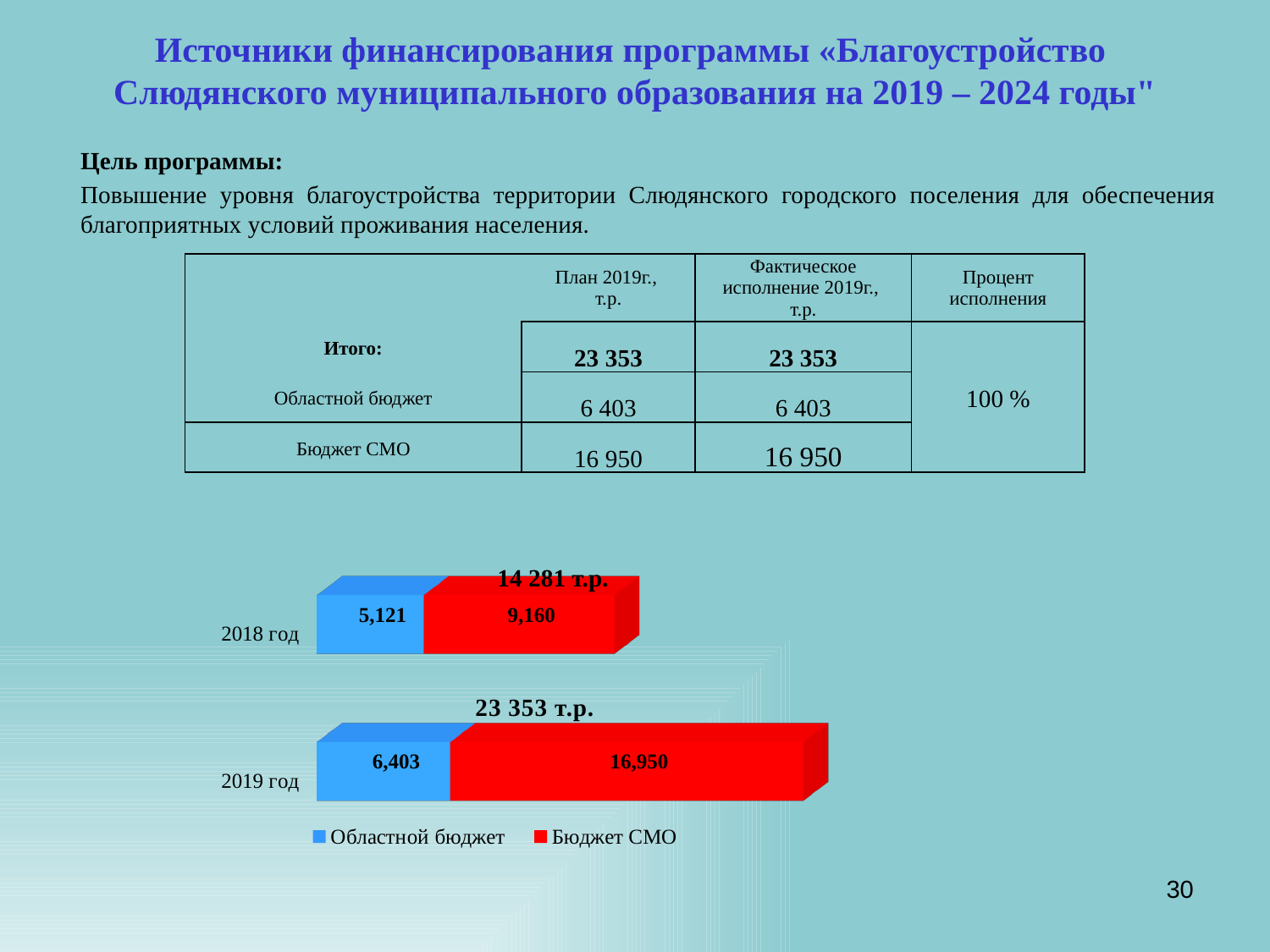
What is the value for Бюджет СМО in 2019 год? 16,950 What is the value for Областной бюджет in 2018 год? 5,121 What is the total of the stacked bar for 2018 год? 14 281 т.р. How many categories (years) are shown in the chart? 2 Which year has the larger value for Бюджет СМО, 2018 год or 2019 год? 2019 год What is the total of the stacked bar for 2019 год? 23 353 т.р. How many series does the legend list? 2 What is the difference between the Бюджет СМО values for 2019 год and 2018 год? 7,790 What is the difference between the Областной бюджет values for 2019 год and 2018 год? 1,282 What is the value for Бюджет СМО in 2018 год? 9,160 What kind of chart is shown on the slide? Stacked bar chart What is the value for Областной бюджет in 2019 год? 6,403